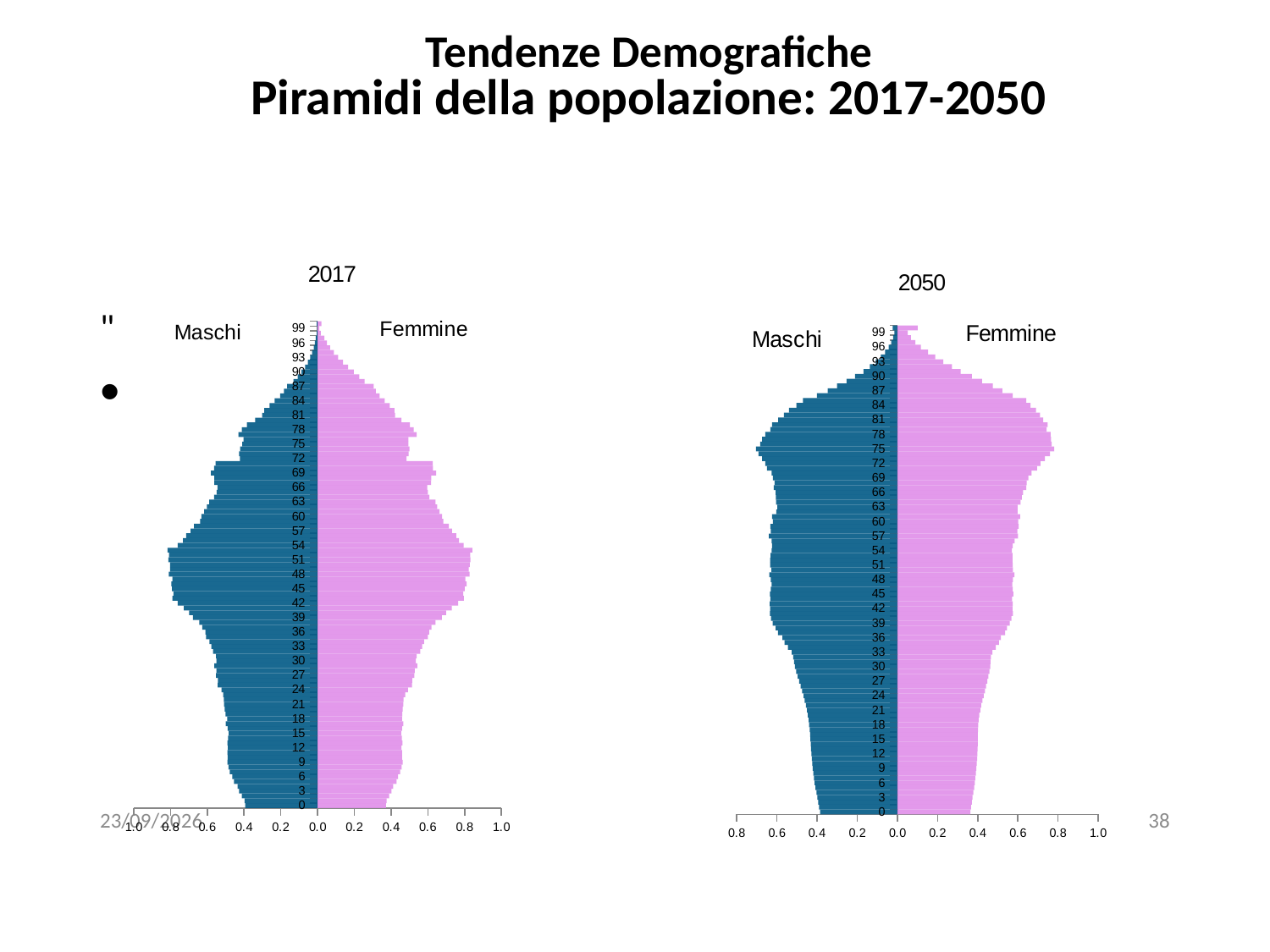
In the 2050 chart, is the Maschi value for age 0 greater or less than 0.6? less In the 2017 chart, is the Maschi value for age 0 greater or less than 0.6? less How many population pyramid charts are shown on the slide? 2 In the 2017 chart, which colour represents Femmine? pink In the 2050 chart, which is larger for Maschi: the value at age 75 or the value at age 3? age 75 What kind of chart is the 2017 population pyramid? bar chart In the 2050 chart, is the Femmine value for age 75 greater or less than 0.6? greater In the 2017 chart, which is larger for Femmine: the value at age 51 or the value at age 21? age 51 In the 2017 chart, how many groups (series) are plotted? 2 In the 2050 chart, what are the two series labels? Maschi and Femmine